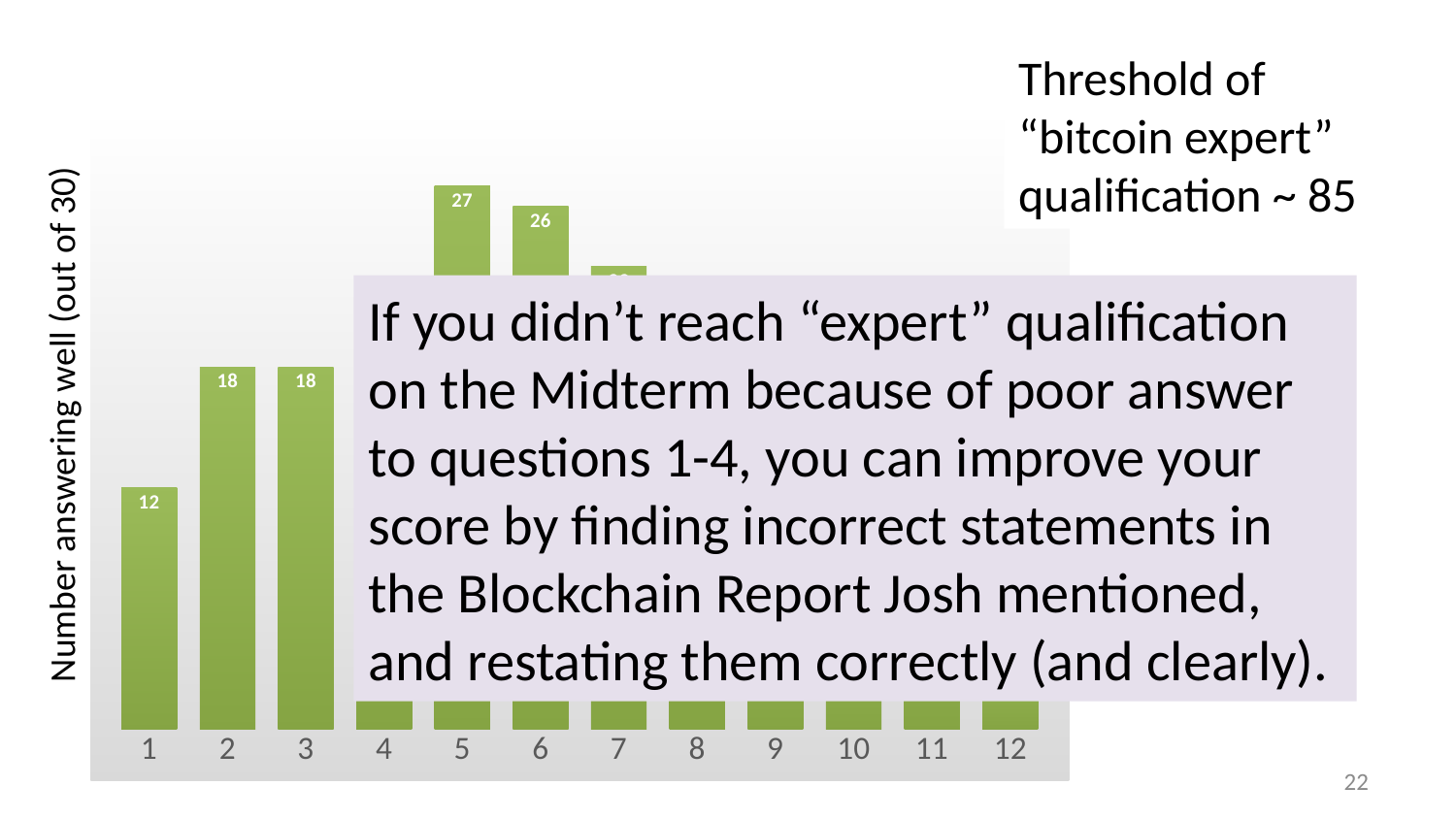
What is the value for category 1? 12 How many categories are shown on the x axis? 12 What is the value for category 6? 26 What is the value for category 2? 18 What is the difference between the values for category 2 and category 1? 6 What is the label of the vertical axis? Number answering well (out of 30) Which is larger, the value for category 5 or category 6? Category 5 What is the difference between the values for category 5 and category 1? 15 What is the value for category 5? 27 Which category has the highest value? 5 What kind of chart is shown on the slide? Bar chart Which is larger, the value for category 1 or category 3? Category 3